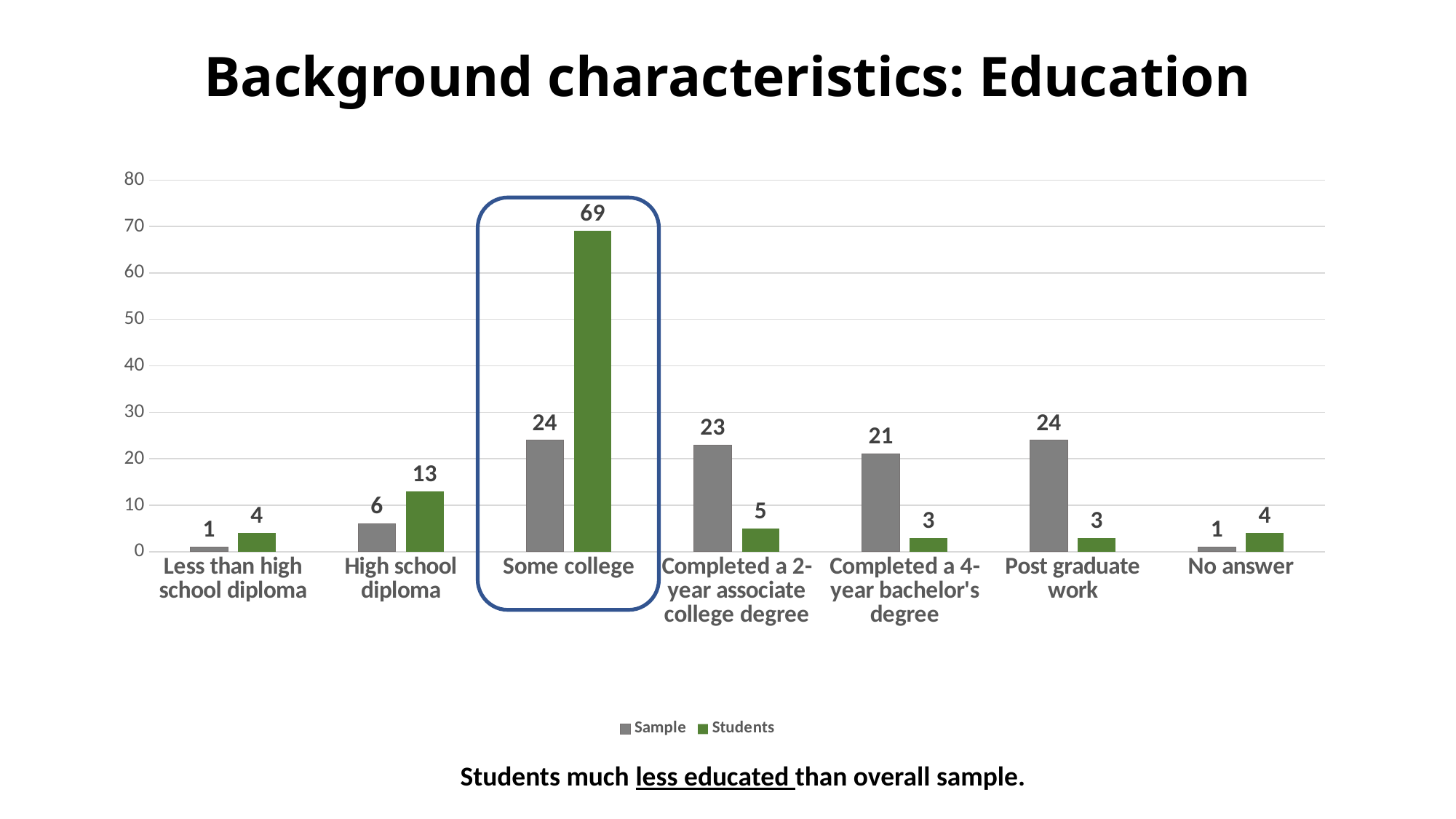
What is the Students value for Some college? 69 What is the Sample value for Completed a 4-year bachelor's degree? 21 Is the Students value for Some college greater or less than 60? greater Which category is highlighted with a blue rounded box? Some college What is the difference between the Students and Sample values for Some college? 45 How many series does the legend list? 2 Which category has the lowest Sample value? Less than high school diploma and No answer (both 1) What is the Students value for High school diploma? 13 How many education categories are shown on the x axis? 7 Which category has the highest Students value? Some college What kind of chart is shown on the slide? Bar chart Which is larger for Post graduate work, the Sample value or the Students value? Sample